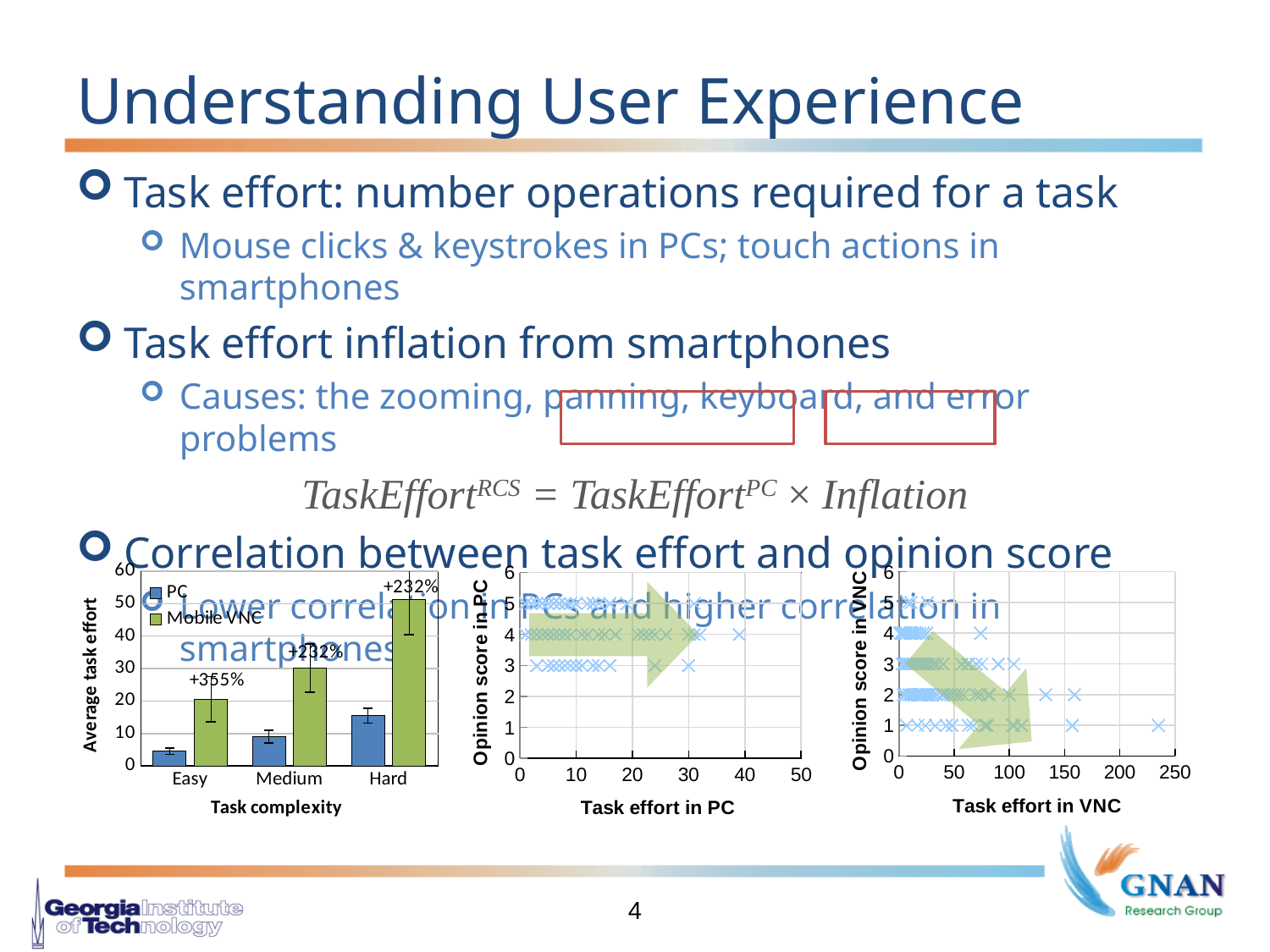
In the leftmost bar chart, do the PC bars rise or fall from Easy to Hard? rise In the leftmost bar chart, what percentage label is printed above the Mobile VNC bar for Easy? +355% In the leftmost bar chart, which task complexity has the highest Mobile VNC bar? Hard What kind of chart is the leftmost chart showing average task effort by task complexity? bar chart In the leftmost bar chart, is the PC value for Hard greater or less than 20? less What is the x-axis title of the middle scatter chart? Task effort in PC In the leftmost bar chart, which task complexity has the lowest PC bar? Easy In the leftmost bar chart, for the Hard task complexity, which series has the larger bar, PC or Mobile VNC? Mobile VNC In the leftmost bar chart, how many series does the legend list? 2 In the leftmost bar chart, is the Mobile VNC value for Hard greater or less than 40? greater What is the y-axis title of the rightmost scatter chart? Opinion score in VNC In the leftmost bar chart, how many task complexity categories are shown on the x axis? 3